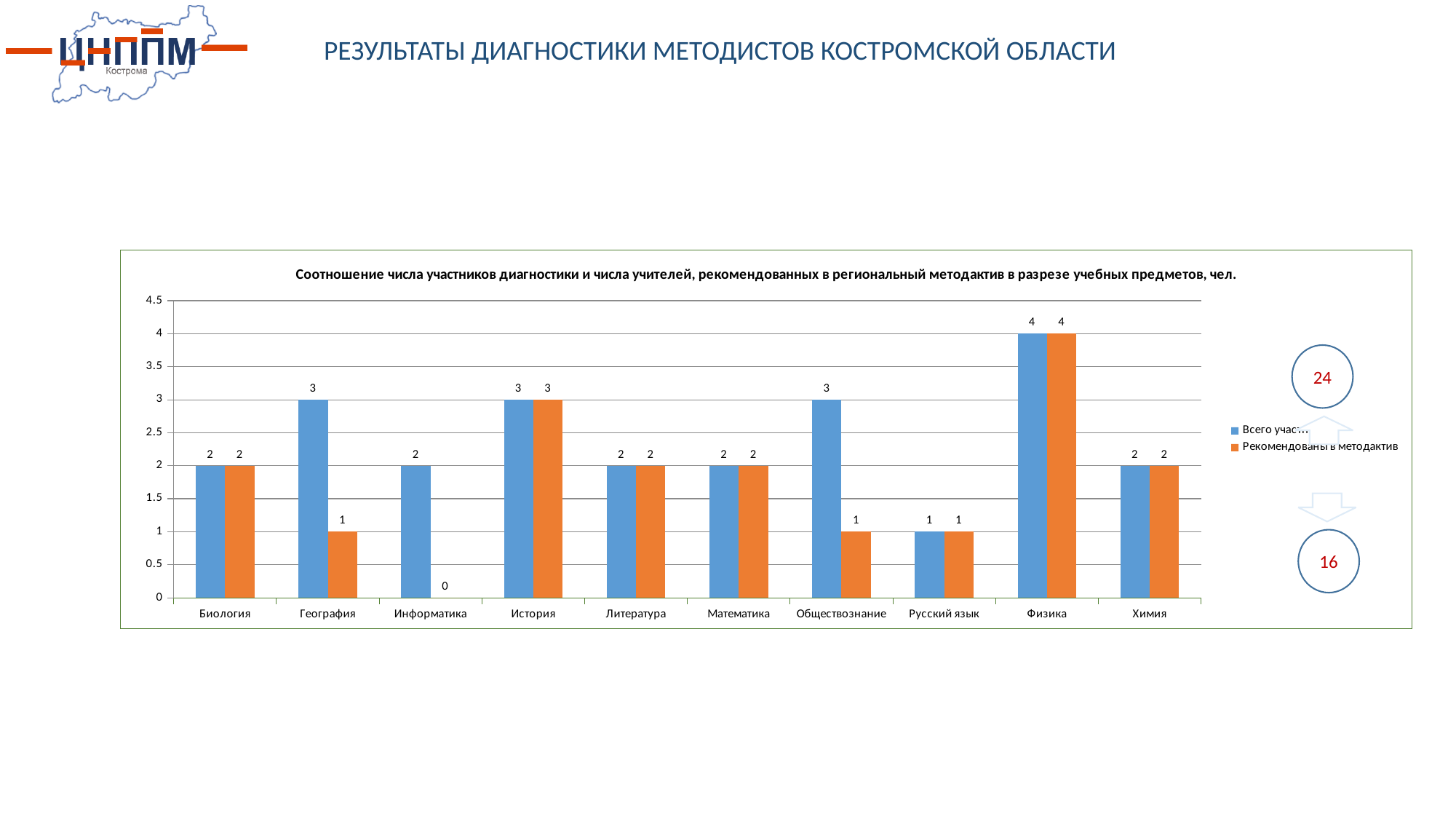
What is the value of the blue (first) series for Физика? 4 Which subject has the lowest value in the blue (first) series? Русский язык What is the value of the blue (first) series for Обществознание? 3 How many subject categories are shown on the x axis of the chart? 10 What is the value of the 'Рекомендованы в методактив' series for География? 1 What kind of chart is shown on the slide? bar chart Which subject has the highest value in the 'Рекомендованы в методактив' series? Физика For География, which is larger: the blue (first) series or the 'Рекомендованы в методактив' series? the blue (first) series What colour are the bars of the 'Рекомендованы в методактив' series? orange What is the difference between the blue (first) series and the 'Рекомендованы в методактив' series for Обществознание? 2 What is the value of the 'Рекомендованы в методактив' series for Информатика? 0 How many series does the chart legend list? 2